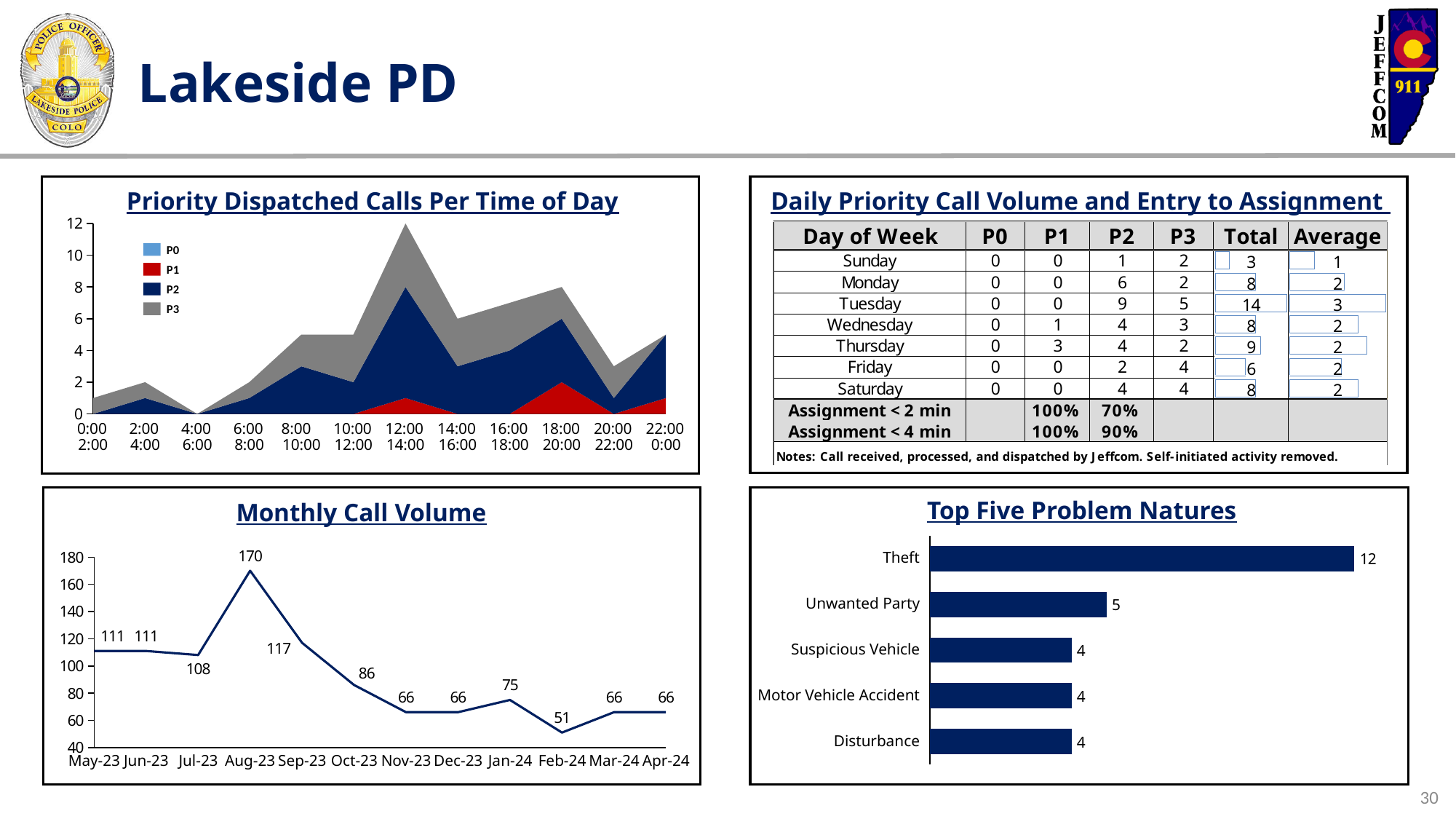
In the Top Five Problem Natures chart, how many problem natures are shown? 5 In the Monthly Call Volume chart, is the value for Oct-23 larger or smaller than the value for Jan-24? larger In the Monthly Call Volume chart, which month has the highest call volume? Aug-23 In the Priority Dispatched Calls Per Time of Day chart, is the total stacked value for the 12:00–14:00 period greater or less than 10? greater In the Monthly Call Volume chart, which month has the lowest call volume? Feb-24 In the Top Five Problem Natures chart, what is the value for Theft? 12 In the Priority Dispatched Calls Per Time of Day chart, how many series does the legend list? 4 What kind of chart is Top Five Problem Natures? bar chart In the Monthly Call Volume chart, how many months are plotted? 12 In the Monthly Call Volume chart, what is the value for Aug-23? 170 In the Monthly Call Volume chart, what is the difference between the values for Aug-23 and Sep-23? 53 In the Top Five Problem Natures chart, what is the difference between Theft and Unwanted Party? 7